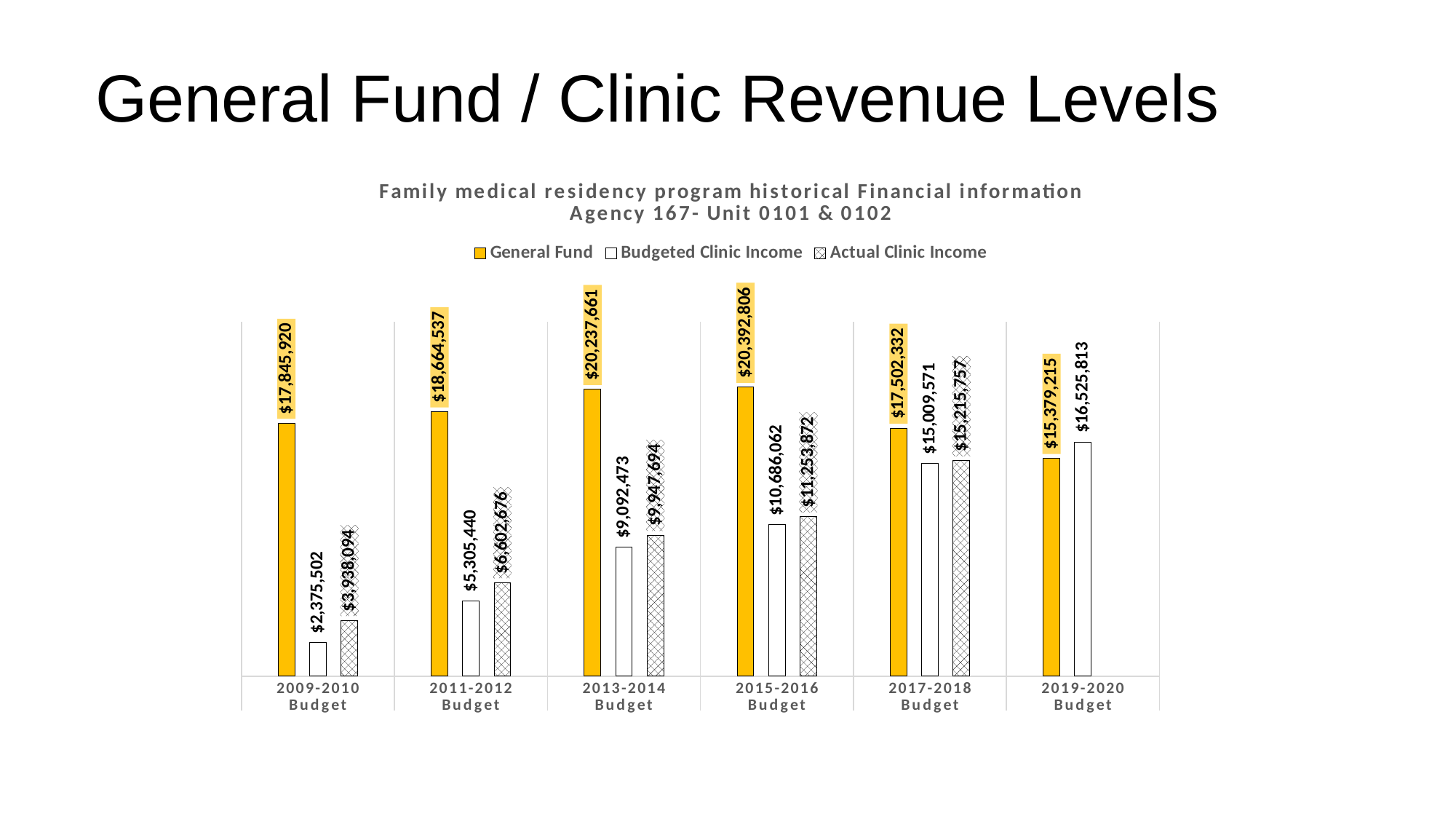
For the 2009-2010 Budget, how much greater is the Actual Clinic Income than the Budgeted Clinic Income? $1,562,592 How many series does the legend list? 3 How many budget periods are shown on the x axis? 6 For the 2019-2020 Budget, which is larger: the General Fund or the Budgeted Clinic Income? Budgeted Clinic Income What is the Budgeted Clinic Income for the 2017-2018 Budget? $15,009,571 Which budget period has the highest General Fund value? 2015-2016 Budget What kind of chart is shown on the slide? Bar chart Which series has no bar shown for the 2019-2020 Budget? Actual Clinic Income Does the Budgeted Clinic Income rise or fall from the 2009-2010 Budget to the 2019-2020 Budget? Rise What is the Actual Clinic Income for the 2011-2012 Budget? $6,602,676 What is the General Fund value for the 2013-2014 Budget? $20,237,661 Which budget period has the lowest Budgeted Clinic Income? 2009-2010 Budget